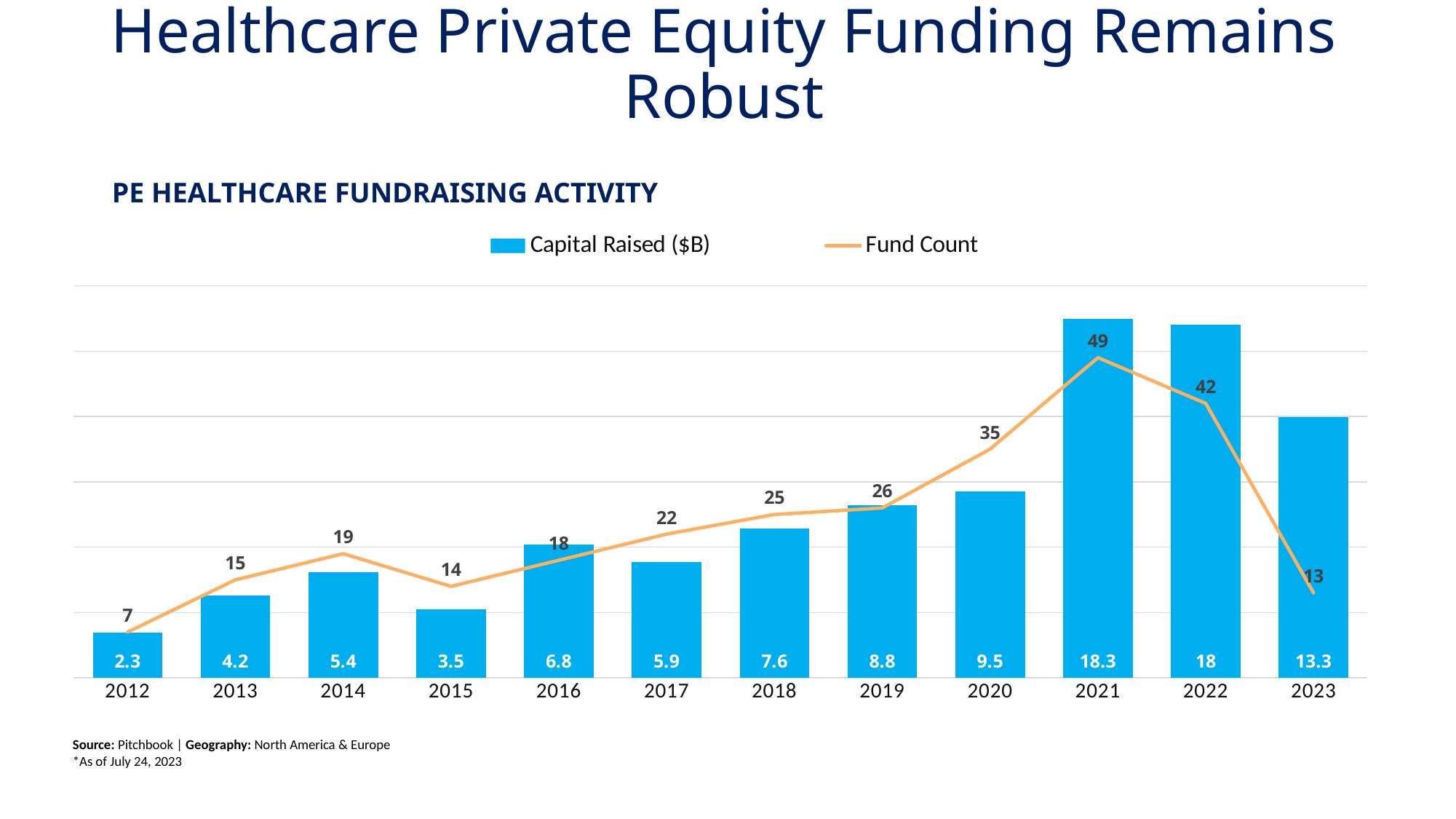
What is the title of the chart? PE HEALTHCARE FUNDRAISING ACTIVITY What is the difference in Fund Count between 2021 and 2022? 7 Did the Fund Count rise or fall from 2021 to 2023? Fall How many years are shown on the x axis? 12 Which year had the lowest Fund Count? 2012 What is the difference in Capital Raised ($B) between 2022 and 2023? 4.7 How many series does the legend list? 2 Which year had the highest Capital Raised ($B)? 2021 Which year had a higher Capital Raised ($B), 2016 or 2017? 2016 What was the Capital Raised ($B) in 2021? 18.3 What kind of chart is used to show Capital Raised ($B)? Bar chart What was the Fund Count in 2019? 26